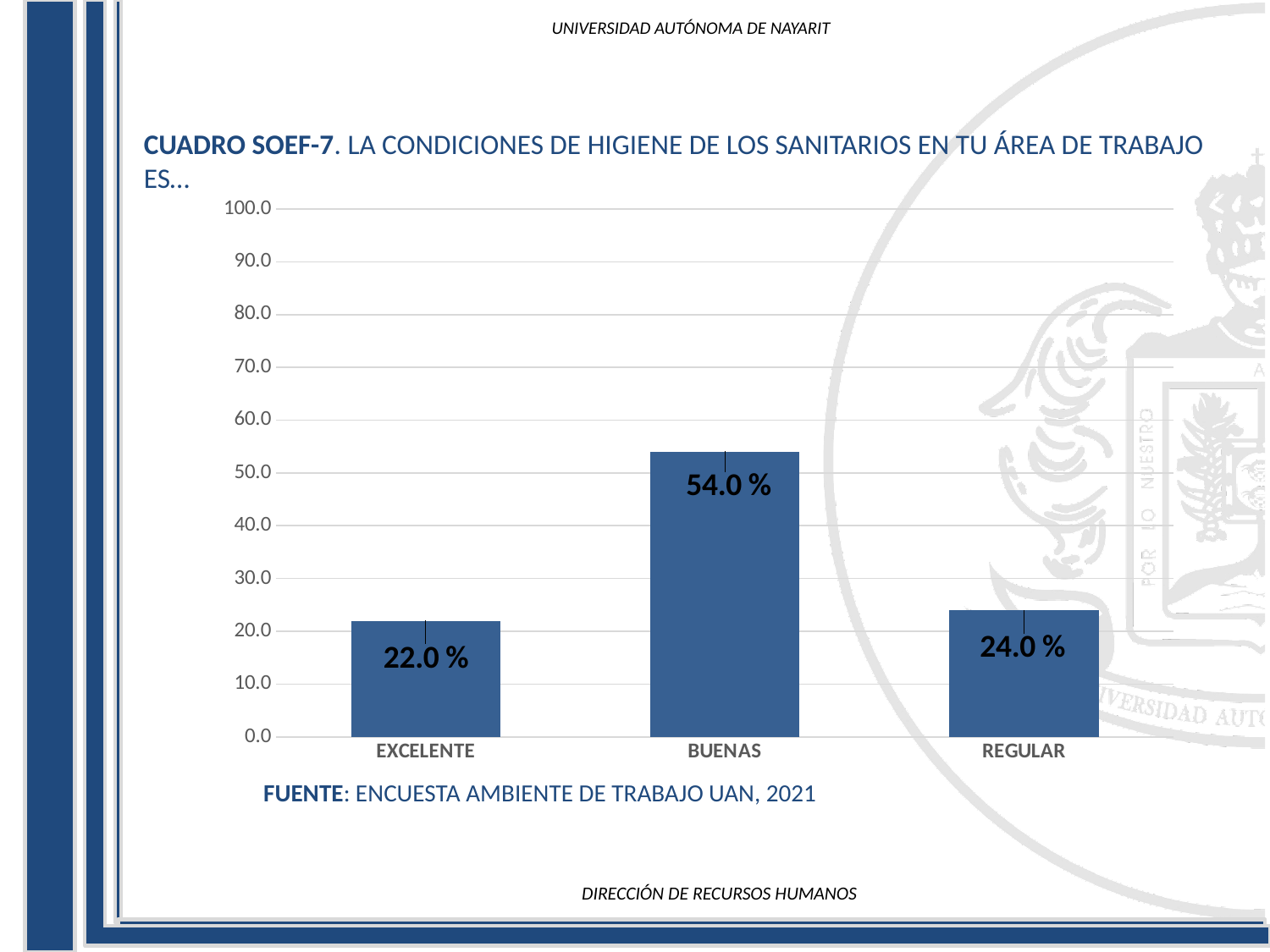
What is the value for BUENAS? 54.0 % What is the source cited below the chart? ENCUESTA AMBIENTE DE TRABAJO UAN, 2021 What is the value for EXCELENTE? 22.0 % Which category has the highest value? BUENAS What is the difference between the values for BUENAS and REGULAR? 30.0 % What kind of chart is shown on the slide? bar chart How many categories are shown on the x axis? 3 Which category has the lowest value? EXCELENTE Which is larger, the value for BUENAS or the value for EXCELENTE? BUENAS Is the value for BUENAS greater or less than 50.0? greater What is the value for REGULAR? 24.0 % What is the difference between the values for REGULAR and EXCELENTE? 2.0 %